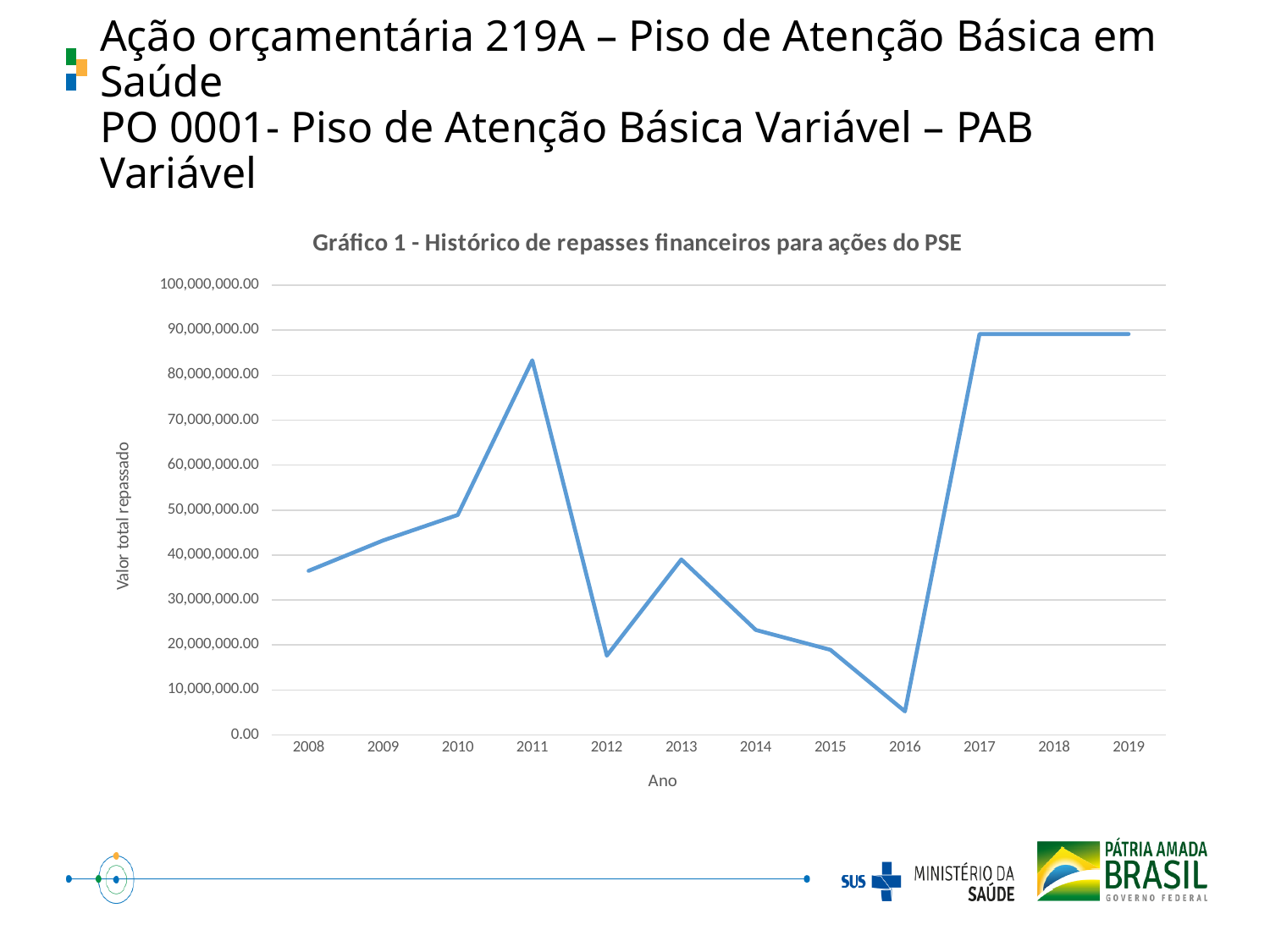
What kind of chart is shown on the slide? line chart How many years are plotted along the x axis? 12 Which is larger, the value for 2013 or the value for 2015? 2013 Is the value for 2011 greater or less than 80,000,000.00? greater Is the value for 2017 greater or less than 80,000,000.00? greater Which year has the lowest value? 2016 Is the value for 2012 greater or less than 20,000,000.00? less What is the label of the y axis? Valor total repassado Do the values rise or fall from 2008 to 2011? rise Which is larger, the value for 2011 or the value for 2012? 2011 What is the title of the chart? Gráfico 1 - Histórico de repasses financeiros para ações do PSE